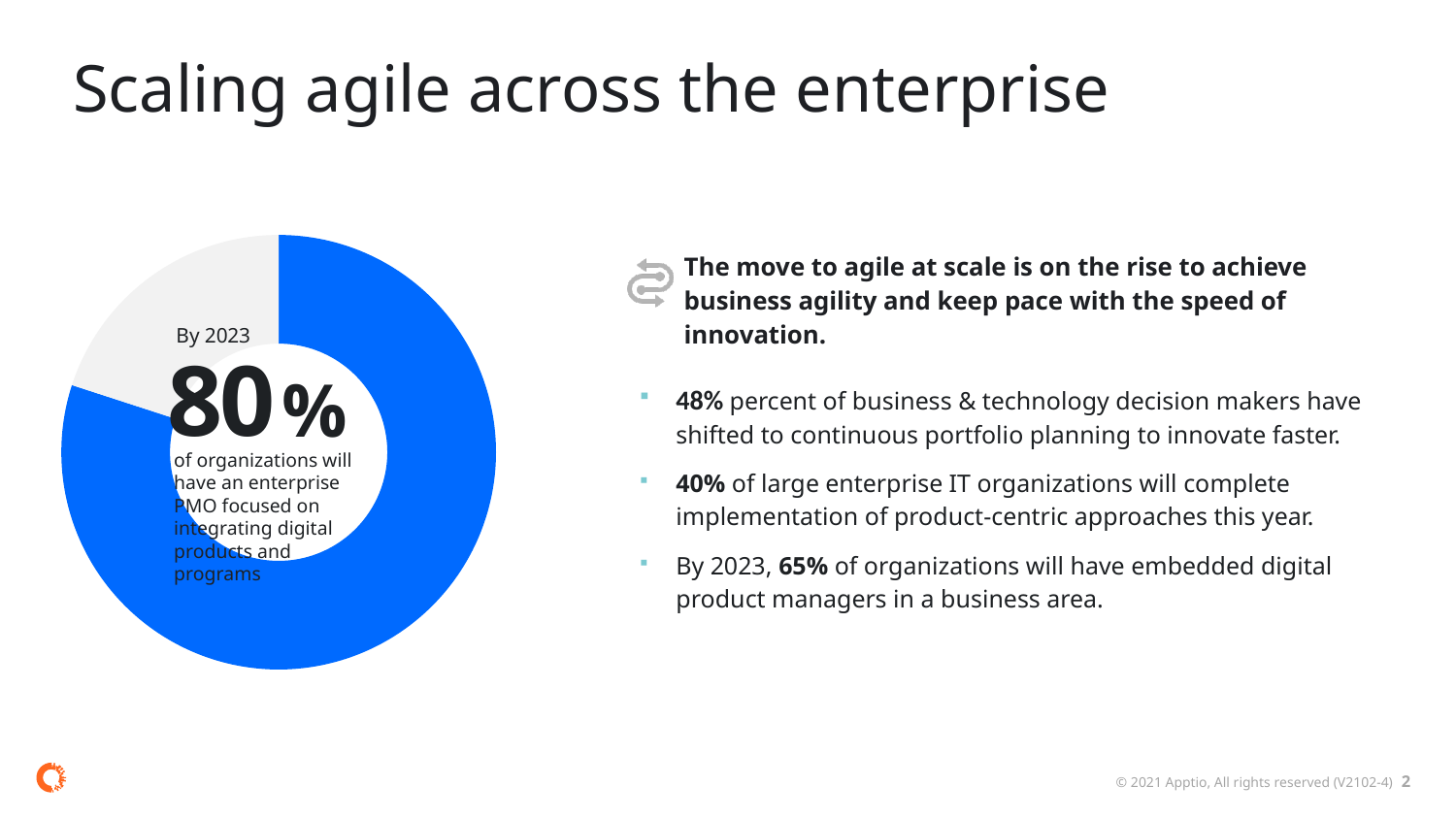
What percentage is printed in the centre of the donut chart? 80% What kind of chart is shown on the left of the slide? Donut (pie) chart What year is referenced in the centre of the donut chart? By 2023 Which segment of the donut chart is larger, the blue one or the grey one? The blue one Is the share shown by the blue segment of the donut chart greater or less than 50%? greater How many segments does the donut chart have? 2 What share of the donut chart does the grey segment represent? 20% What share of the donut chart does the blue segment represent? 80% According to the donut chart, what will 80% of organizations have by 2023? An enterprise PMO focused on integrating digital products and programs